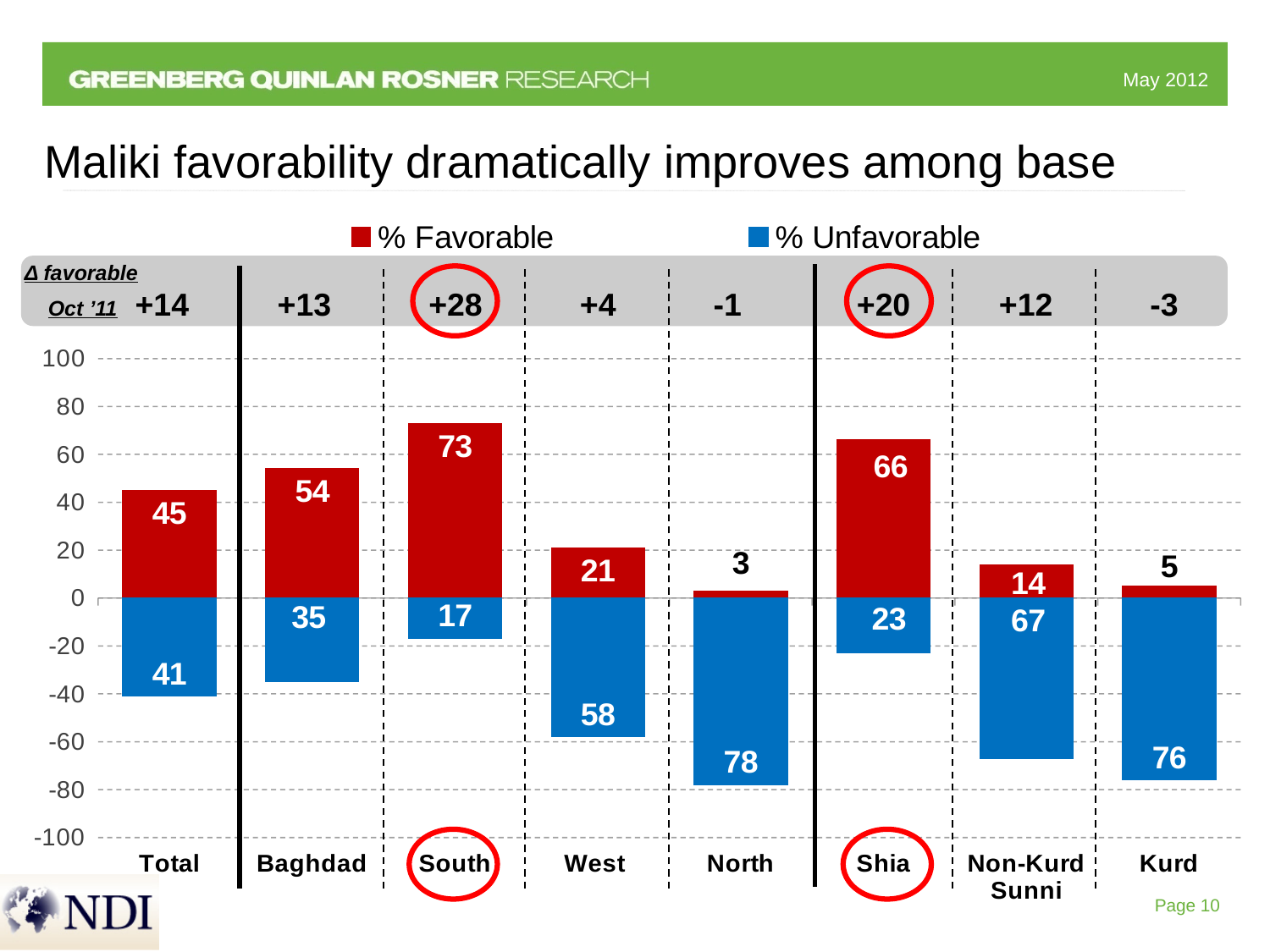
Which category has the highest % Unfavorable value? North What is the % Unfavorable value for North? 78 What is the % Favorable value for Shia? 66 Which is larger, the % Unfavorable value for Kurd or for West? Kurd What is the difference between the % Favorable values for South and Baghdad? 19 How many series does the legend list? 2 How many categories are shown on the x axis? 8 Which category has the lowest % Favorable value? North What kind of chart is shown on the slide? Bar chart What is the % Favorable value for South? 73 What is the % Unfavorable value for Non-Kurd Sunni? 67 Which category has the highest % Favorable value? South